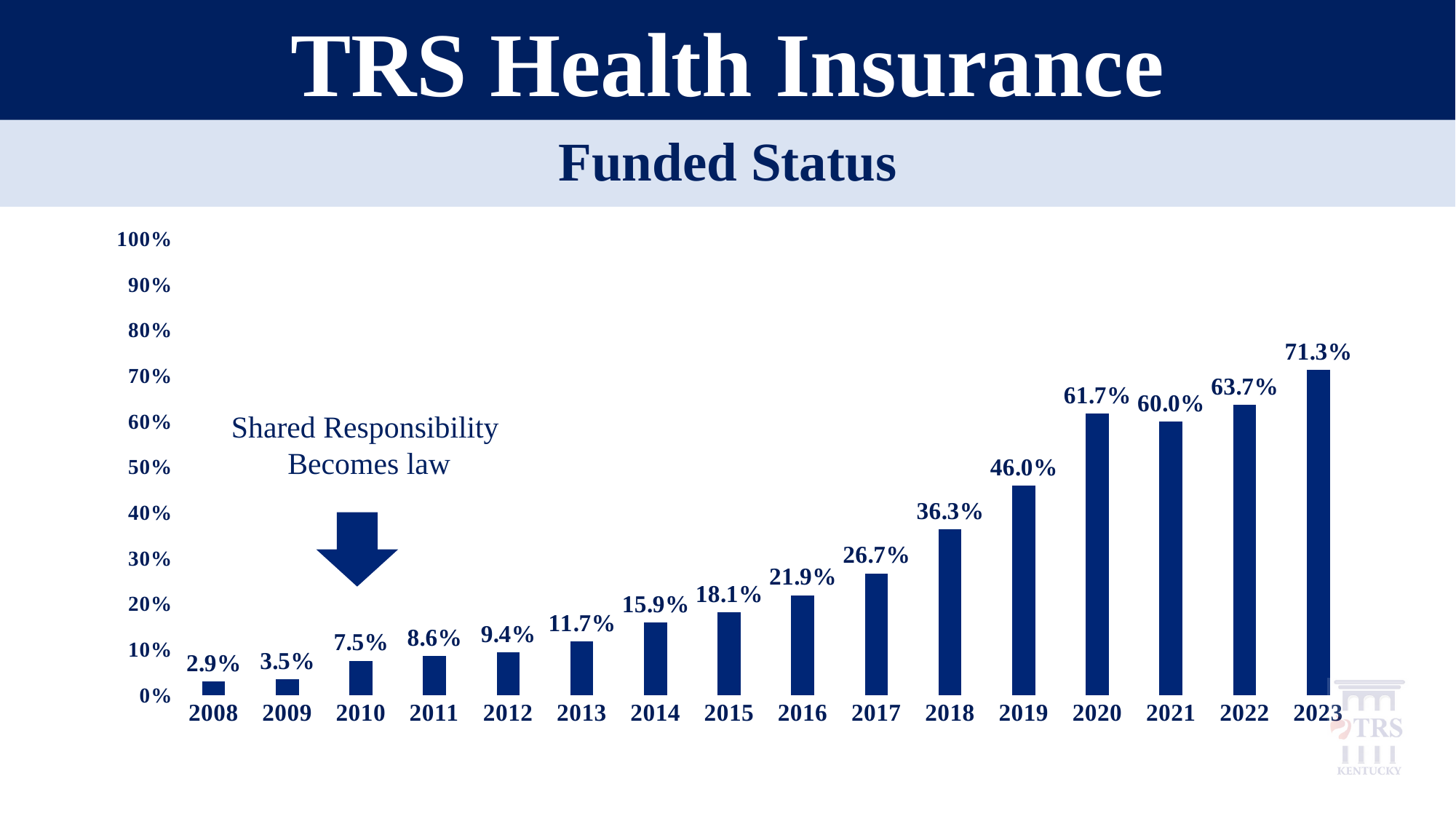
Which year has the highest funded status? 2023 Which year has the lowest funded status? 2008 What is the funded status for 2020? 61.7% Is the funded status for 2019 greater or less than 40%? greater What is the difference in funded status between 2023 and 2022? 7.6% What kind of chart is shown on the slide? bar chart How many years are shown on the x axis? 16 Which year has a higher funded status, 2020 or 2021? 2020 What is the funded status for 2015? 18.1% What event does the annotation with the arrow point to on the chart? Shared Responsibility Becomes law What is the funded status for 2008? 2.9% Does the funded status rise or fall from 2008 to 2023? rise